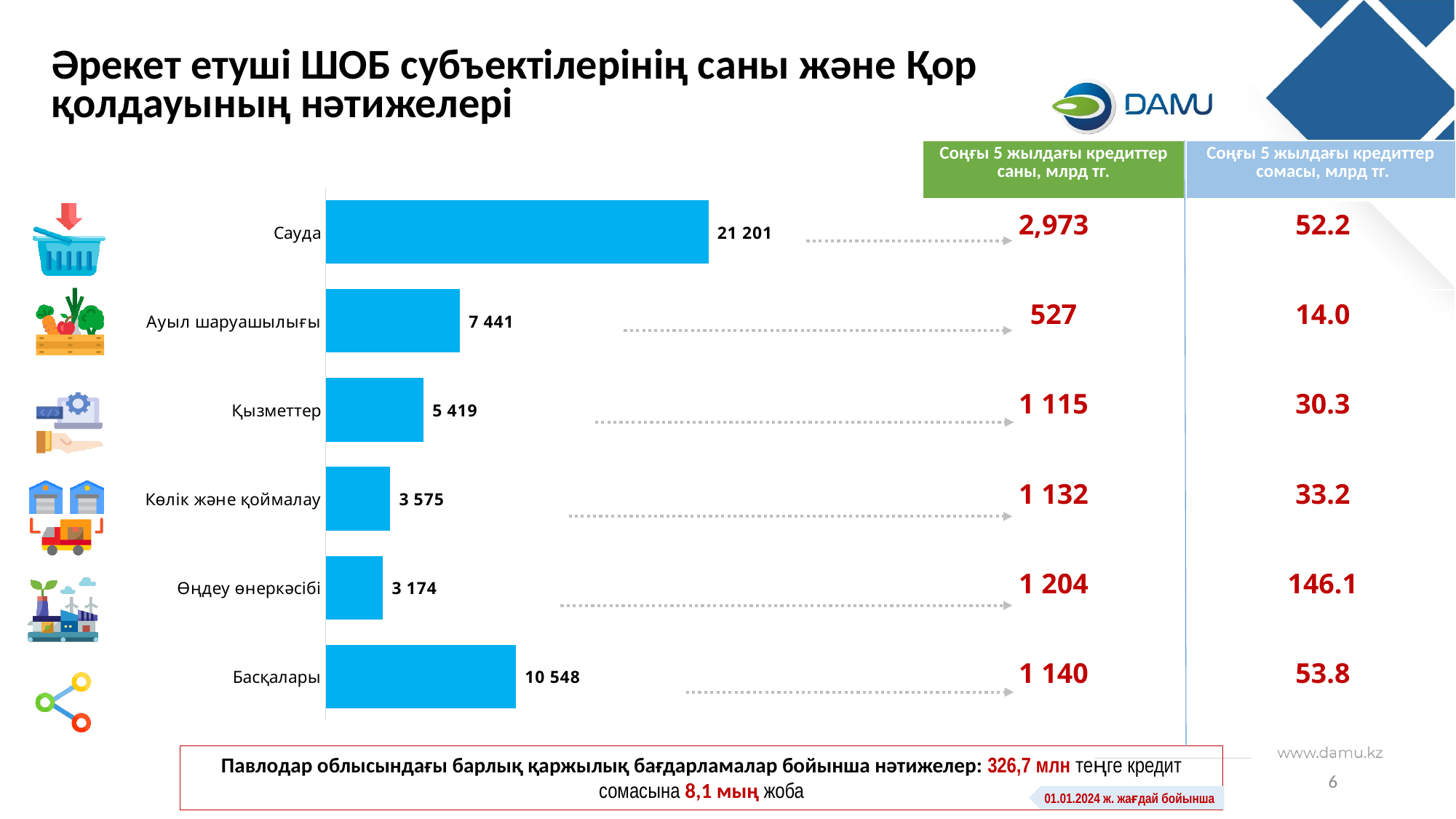
What is the value for Ауыл шаруашылығы in the bar chart? 7 441 How many categories does the bar chart show? 6 What is the value for Қызметтер in the bar chart? 5 419 Which category has the lowest value in the bar chart? Өңдеу өнеркәсібі What kind of chart is shown on the slide? bar chart Which is larger, the value for Ауыл шаруашылығы or the value for Қызметтер? Ауыл шаруашылығы What is the value for Сауда in the bar chart? 21 201 Which category has the highest value in the bar chart? Сауда What is the difference between the values for Сауда and Басқалары? 10 653 What is the difference between the values for Көлік және қоймалау and Өңдеу өнеркәсібі? 401 What is the value for Басқалары in the bar chart? 10 548 What colour are the bars in the chart? blue